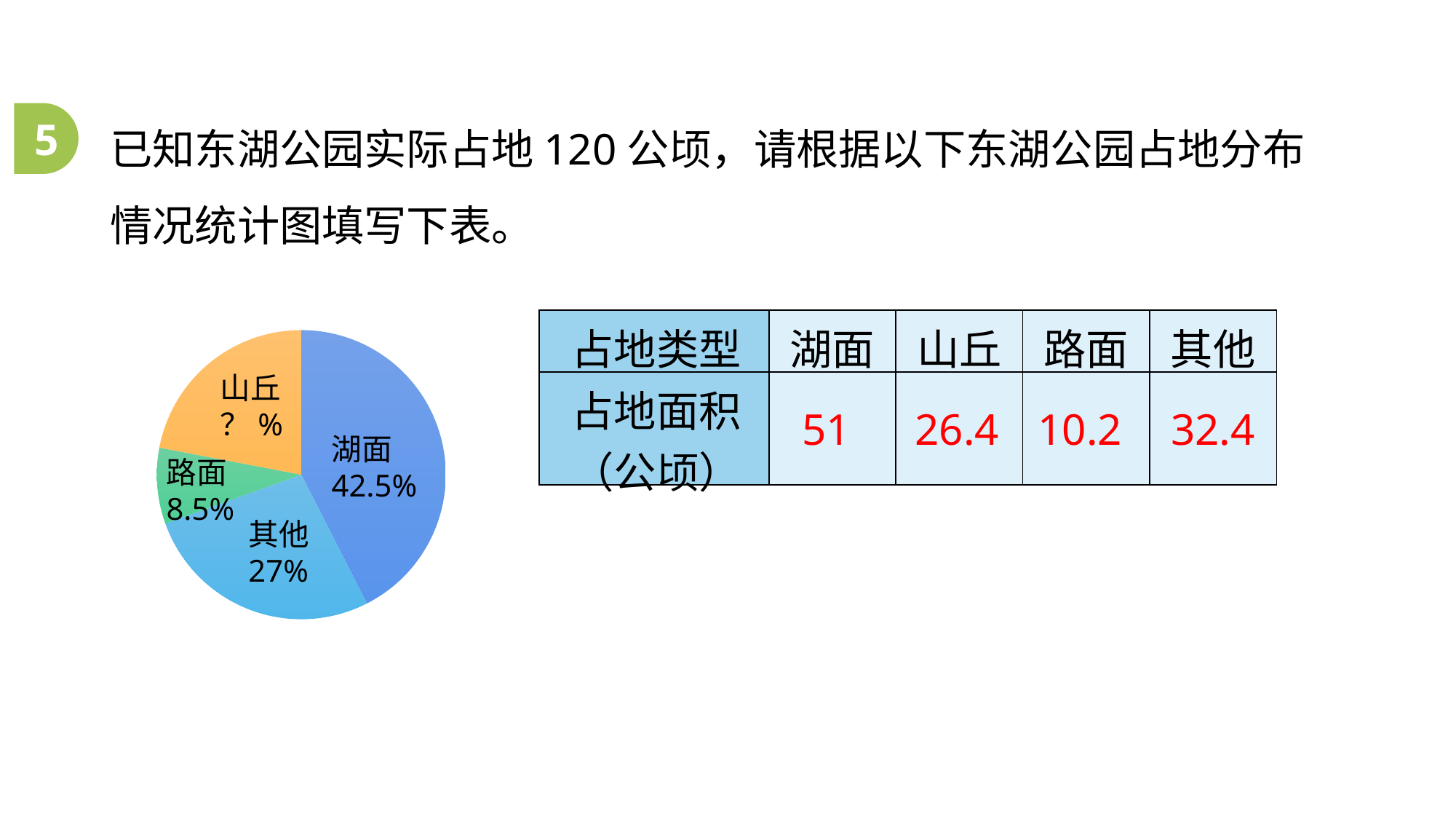
How many categories are shown in the pie chart? 4 What is the difference in percentage points between the 其他 slice and the 路面 slice? 18.5% Which category has the largest slice in the pie chart? 湖面 What kind of chart is shown on the slide? Pie chart What percentage does the 其他 slice represent in the pie chart? 27% What colour is the 路面 slice in the pie chart? Green What is the difference in percentage points between the 湖面 slice and the 其他 slice? 15.5% What percentage does the 湖面 slice represent in the pie chart? 42.5% Which slice of the pie chart has its percentage shown as a question mark instead of a value? 山丘 Which slice is larger, 其他 or 路面? 其他 What percentage does the 路面 slice represent in the pie chart? 8.5% Which category has the smallest slice in the pie chart? 路面